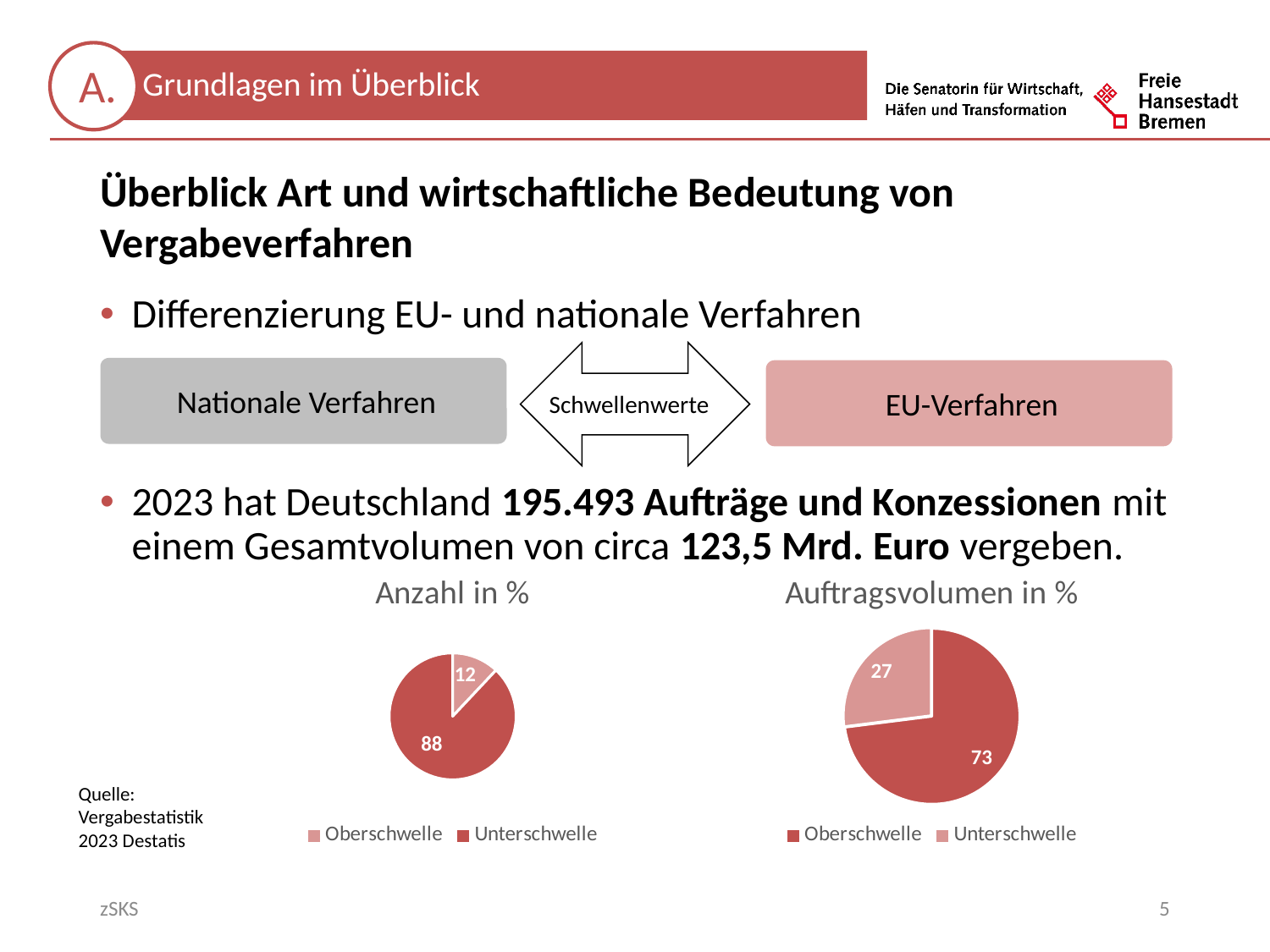
Is the Oberschwelle value larger in the 'Anzahl in %' chart or in the 'Auftragsvolumen in %' chart? Auftragsvolumen in % In the 'Anzahl in %' pie chart, what is the difference between the Unterschwelle and Oberschwelle values? 76 In the 'Auftragsvolumen in %' pie chart, what is the difference between the Oberschwelle and Unterschwelle values? 46 How many categories does the legend of the 'Auftragsvolumen in %' chart list? 2 What type of chart is used for 'Anzahl in %'? Pie chart What is the title of the pie chart on the right side of the slide? Auftragsvolumen in % In the 'Anzahl in %' pie chart, what value is shown for Oberschwelle? 12 In the 'Auftragsvolumen in %' pie chart, which category has the smallest slice? Unterschwelle In the 'Auftragsvolumen in %' pie chart, what value is shown for Unterschwelle? 27 In the 'Auftragsvolumen in %' pie chart, what value is shown for Oberschwelle? 73 In the 'Anzahl in %' pie chart, which category has the largest slice? Unterschwelle In the 'Anzahl in %' pie chart, what value is shown for Unterschwelle? 88